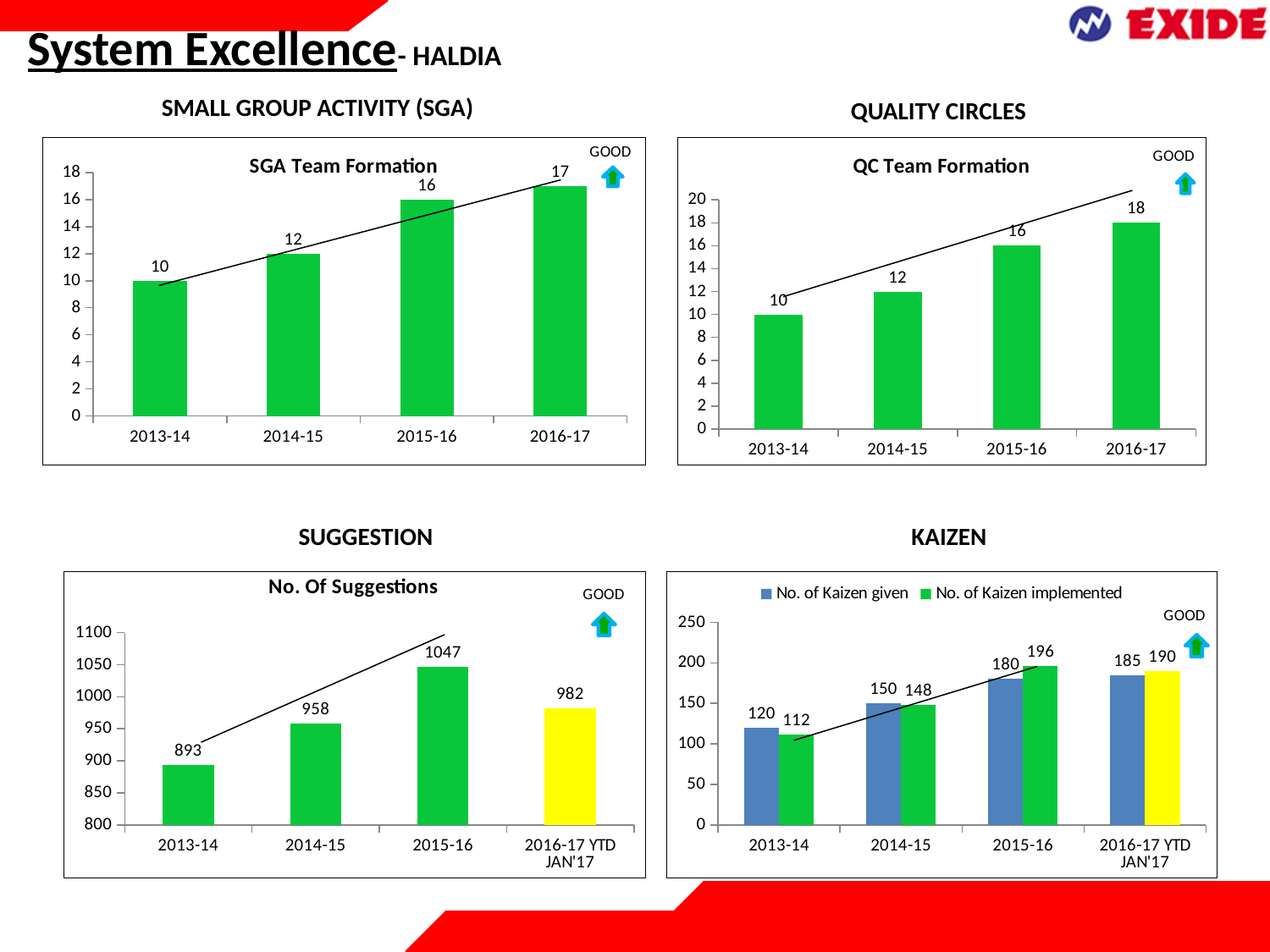
In the KAIZEN chart, what is the No. of Kaizen implemented for 2015-16? 196 In the No. Of Suggestions chart, what is the value for 2014-15? 958 In the No. Of Suggestions chart, how many categories are shown on the x axis? 4 In the QC Team Formation chart, do the values rise or fall from 2013-14 to 2016-17? rise In the SGA Team Formation chart, what is the value for 2015-16? 16 In the QC Team Formation chart, what is the difference between the 2016-17 and 2013-14 values? 8 What kind of chart is the SGA Team Formation chart? bar chart In the KAIZEN chart, how many series does the legend list? 2 In the No. Of Suggestions chart, which year has the highest value? 2015-16 In the KAIZEN chart, which is larger for 2013-14: No. of Kaizen given or No. of Kaizen implemented? No. of Kaizen given In the QC Team Formation chart, what is the value for 2016-17? 18 In the SGA Team Formation chart, which year has the lowest value? 2013-14